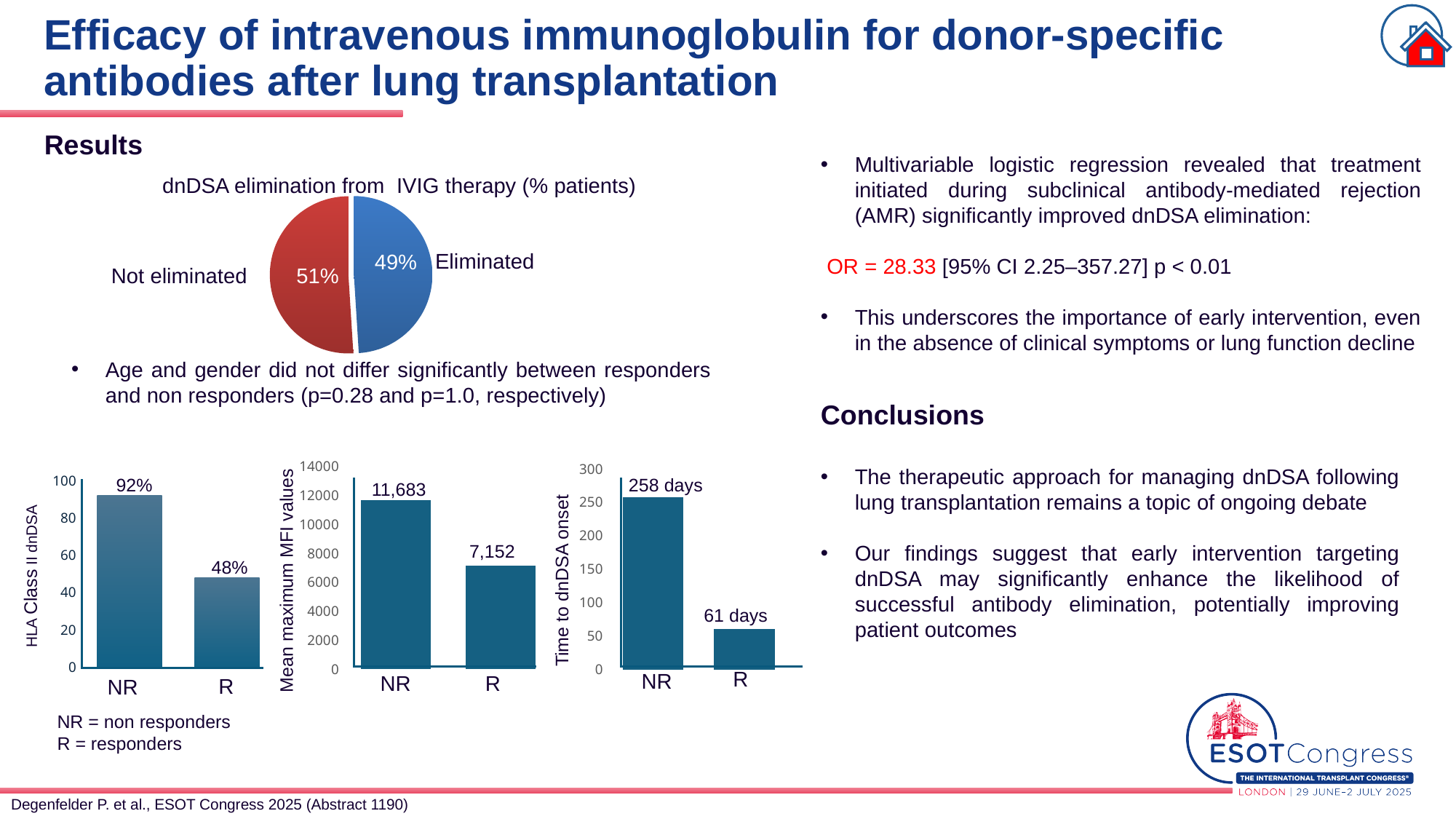
In the bar chart with the y-axis 'HLA Class II dnDSA', what is the value for R? 48% In the pie chart titled 'dnDSA elimination from IVIG therapy (% patients)', which slice is coloured red? Not eliminated What kind of chart is the one with the y-axis 'Time to dnDSA onset'? Bar chart In the bar chart with the y-axis 'HLA Class II dnDSA', what is the difference between the NR and R values? 44% In the pie chart titled 'dnDSA elimination from IVIG therapy (% patients)', how many slices are there? 2 In the bar chart with the y-axis 'Time to dnDSA onset', what is the difference between the NR and R values? 197 days In the pie chart titled 'dnDSA elimination from IVIG therapy (% patients)', what share of patients is labelled 'Not eliminated'? 51% In the pie chart titled 'dnDSA elimination from IVIG therapy (% patients)', what percentage of patients had dnDSA eliminated? 49% In the bar chart with the y-axis 'Time to dnDSA onset', what is the value for R? 61 days In the bar chart with the y-axis 'Mean maximum MFI values', which group has the lower value? R In the bar chart with the y-axis 'HLA Class II dnDSA', what is the value for NR? 92% In the bar chart with the y-axis 'Mean maximum MFI values', what is the value for NR? 11,683